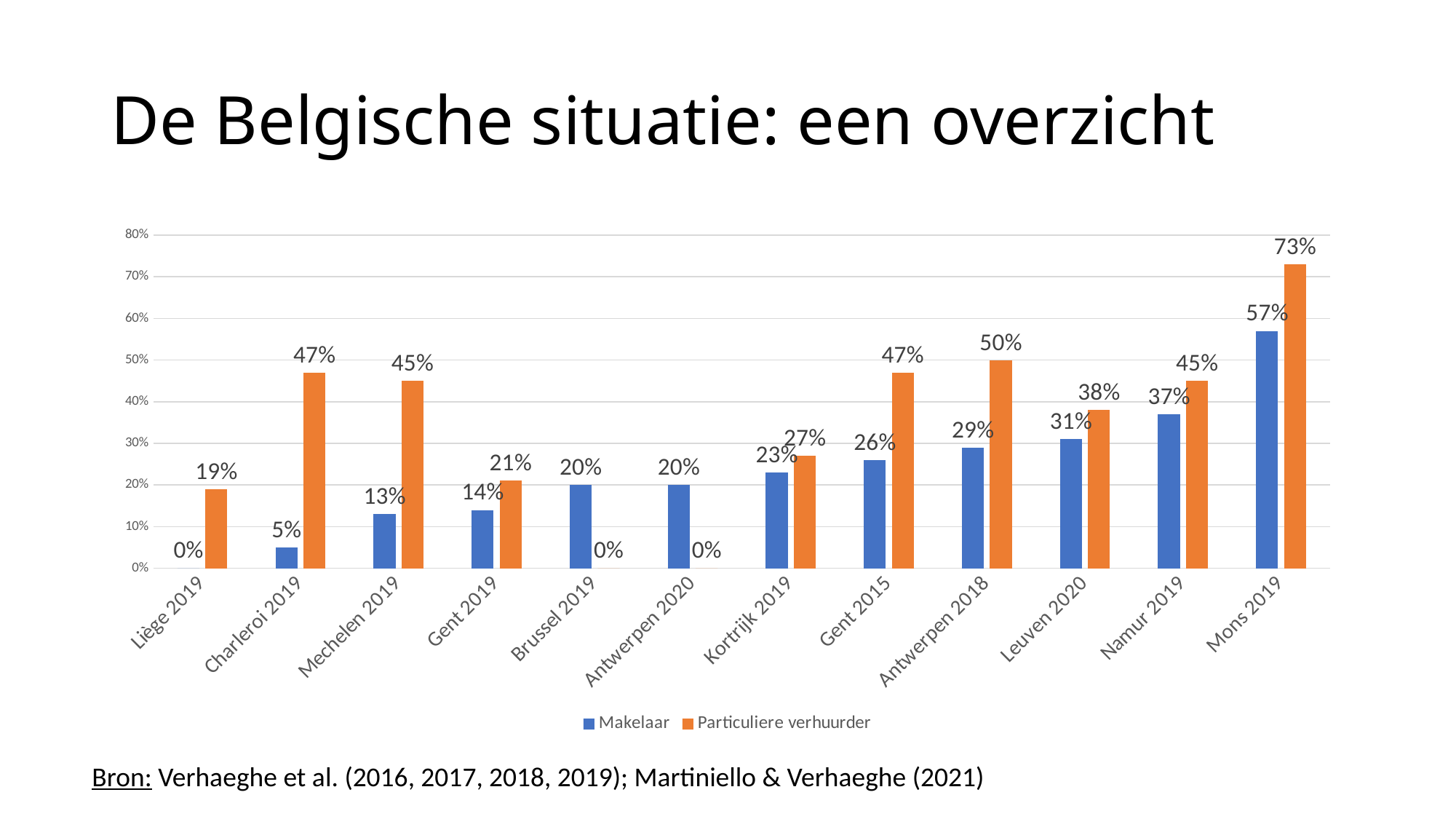
What is the difference between the Particuliere verhuurder and Makelaar values for Charleroi 2019? 42 percentage points How many series does the legend list? 2 Which is larger for Gent 2015: the Makelaar value or the Particuliere verhuurder value? Particuliere verhuurder Is the Particuliere verhuurder value for Antwerpen 2018 greater or less than 40%? greater What is the Makelaar value for Kortrijk 2019? 23% What is the difference between the Particuliere verhuurder and Makelaar values for Mons 2019? 16 percentage points What kind of chart is shown on the slide? Bar chart Which category has the highest Particuliere verhuurder value? Mons 2019 What is the Particuliere verhuurder value for Charleroi 2019? 47% How many categories are shown on the x axis? 12 Which category has the lowest Makelaar value? Liège 2019 What is the Makelaar value for Mons 2019? 57%